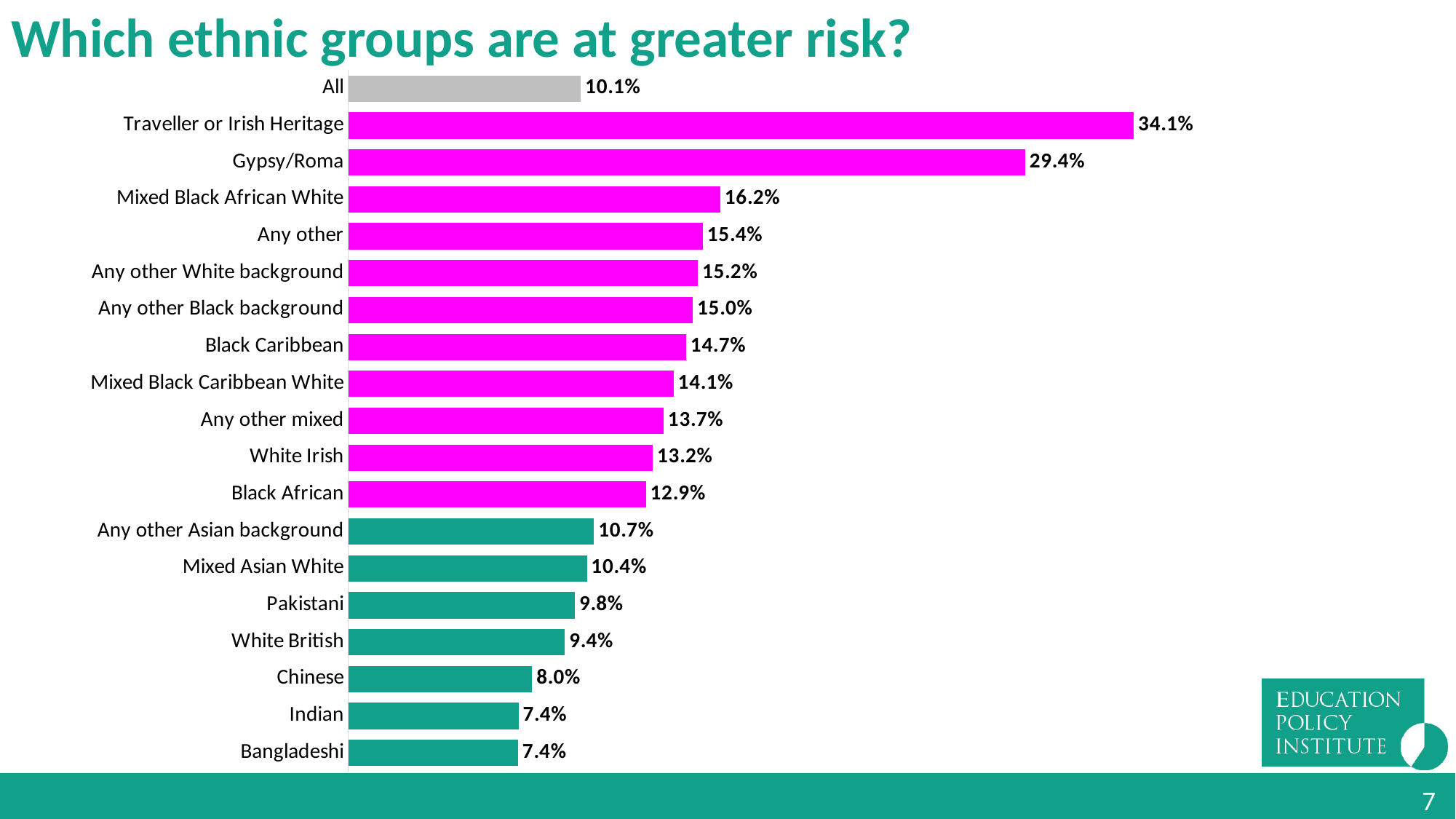
What is the difference between the values for Mixed Black African White and the All category? 6.1% What is the value for White British? 9.4% What kind of chart is shown on the slide? Bar chart What is the title of the slide? Which ethnic groups are at greater risk? How many categories are shown in the chart, including All? 19 What is the value for Black Caribbean? 14.7% Which is larger, the value for Pakistani or the value for Chinese? Pakistani Which is larger, the value for White Irish or the value for Black African? White Irish What is the difference between the values for Traveller or Irish Heritage and Gypsy/Roma? 4.7% What is the value for the All category? 10.1% What is the value for Traveller or Irish Heritage? 34.1% Which ethnic group has the highest value? Traveller or Irish Heritage